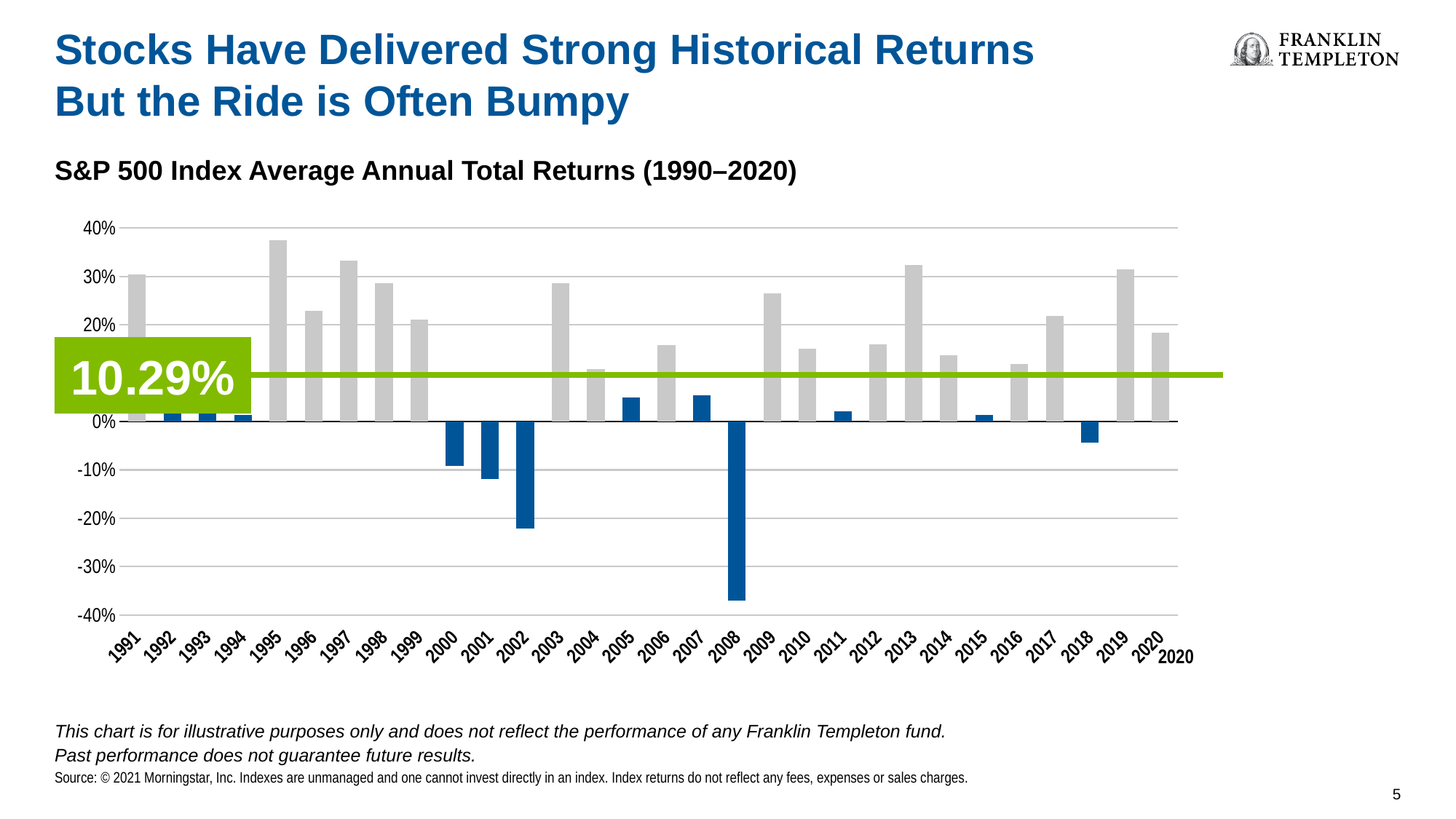
What is the title of the chart? S&P 500 Index Average Annual Total Returns (1990–2020) Is the value for 2017 greater or less than 20%? greater Which year has the lowest return in the chart? 2008 Is the value for 2002 greater or less than -20%? less How many years have a negative return (bar below 0%) in the chart? 5 Which year has the lower return, 2002 or 2008? 2008 What kind of chart is shown on the slide? bar chart What value is printed on the green horizontal line across the chart? 10.29% Is the value for 2008 greater or less than -30%? less Which year has the larger return, 1995 or 1997? 1995 Which year has the highest return in the chart? 1995